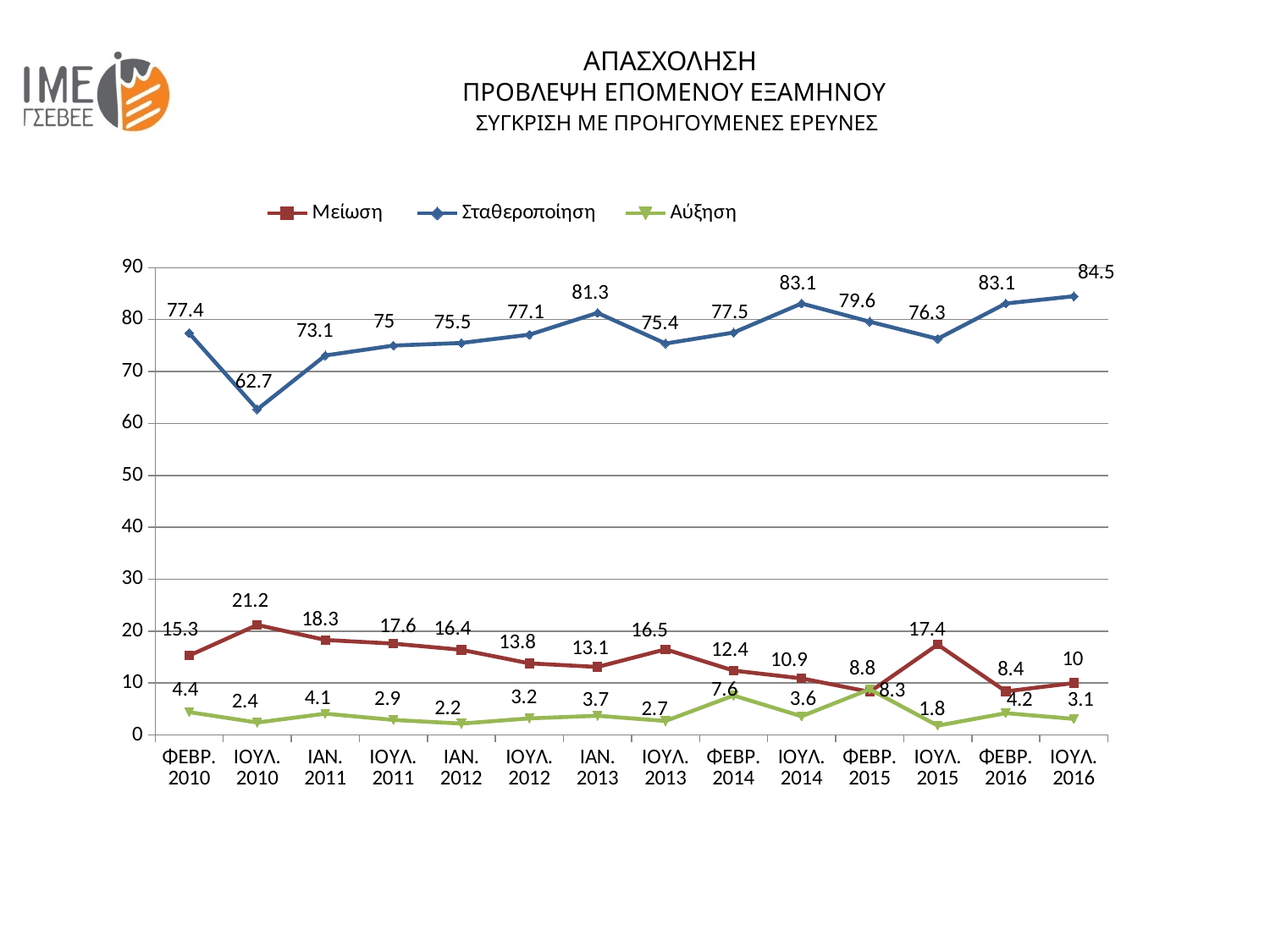
Which series is shown in blue in the legend? Σταθεροποίηση What is the value of Σταθεροποίηση for ΙΟΥΛ. 2016? 84.5 What type of chart is shown on the slide? line chart At which time point is Μείωση highest? ΙΟΥΛ. 2010 How many series does the legend list? 3 Which is larger, Μείωση for ΙΑΝ. 2013 or Μείωση for ΙΟΥΛ. 2013? ΙΟΥΛ. 2013 What is the difference between Σταθεροποίηση for ΙΟΥΛ. 2016 and ΦΕΒΡ. 2010? 7.1 What is the value of Αύξηση for ΦΕΒΡ. 2014? 7.6 At which time point is Αύξηση lowest? ΙΟΥΛ. 2015 What is the value of Μείωση for ΙΟΥΛ. 2010? 21.2 How many time points are shown on the x axis? 14 At which time point is Σταθεροποίηση lowest? ΙΟΥΛ. 2010